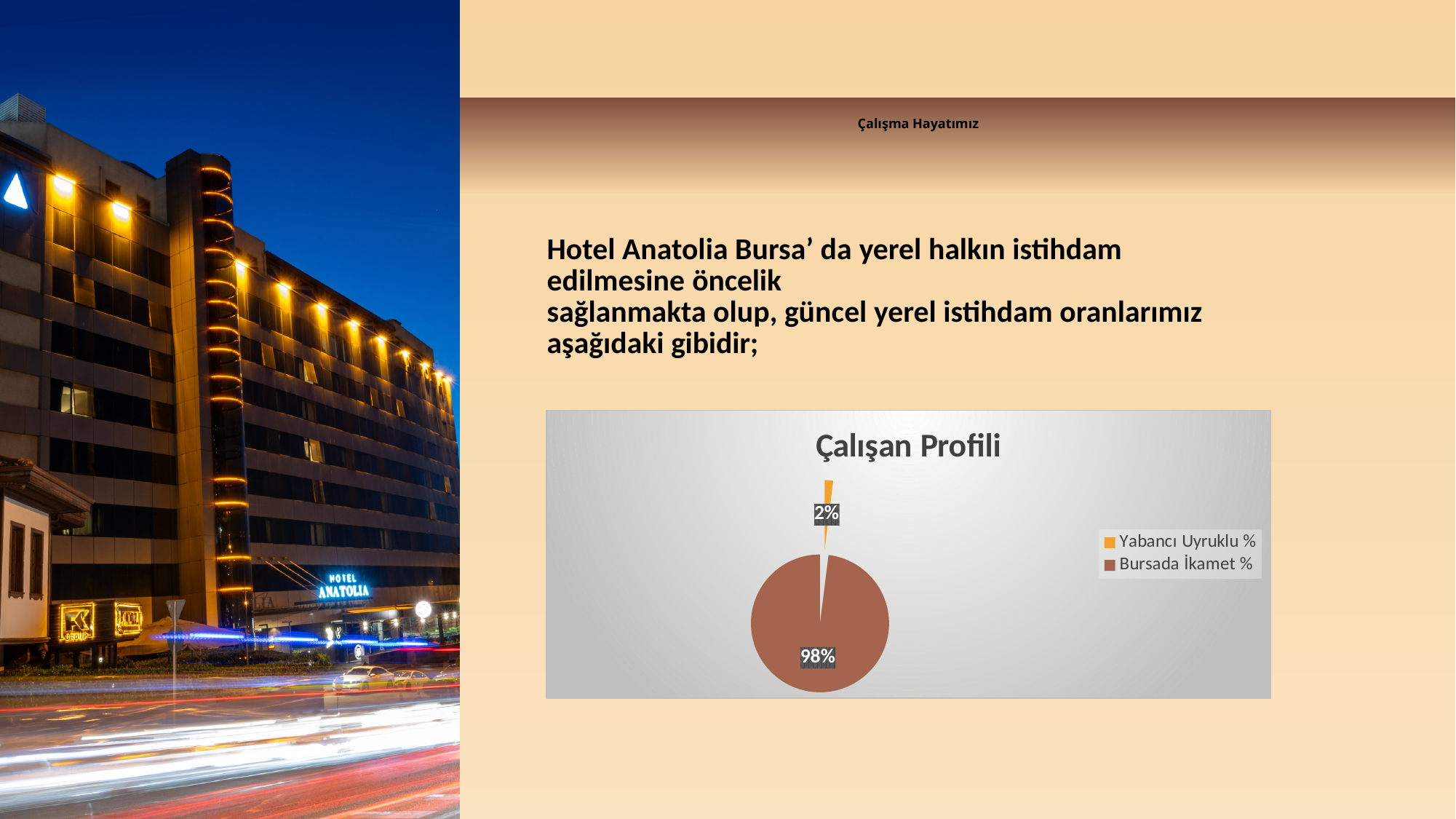
Which is larger, Yabancı Uyruklu % or Bursada İkamet %? Bursada İkamet % How many slices does the pie chart have? 2 What is the difference in percentage points between Bursada İkamet % and Yabancı Uyruklu %? 96 What colour is the Yabancı Uyruklu % slice? orange What kind of chart is shown on the slide? pie chart Which slice of the pie is the largest? Bursada İkamet % Which slice of the pie is the smallest? Yabancı Uyruklu % What share of the pie does Yabancı Uyruklu % have? 2% What share of the pie does Bursada İkamet % have? 98% How many entries does the legend list? 2 What is the title of the chart? Çalışan Profili